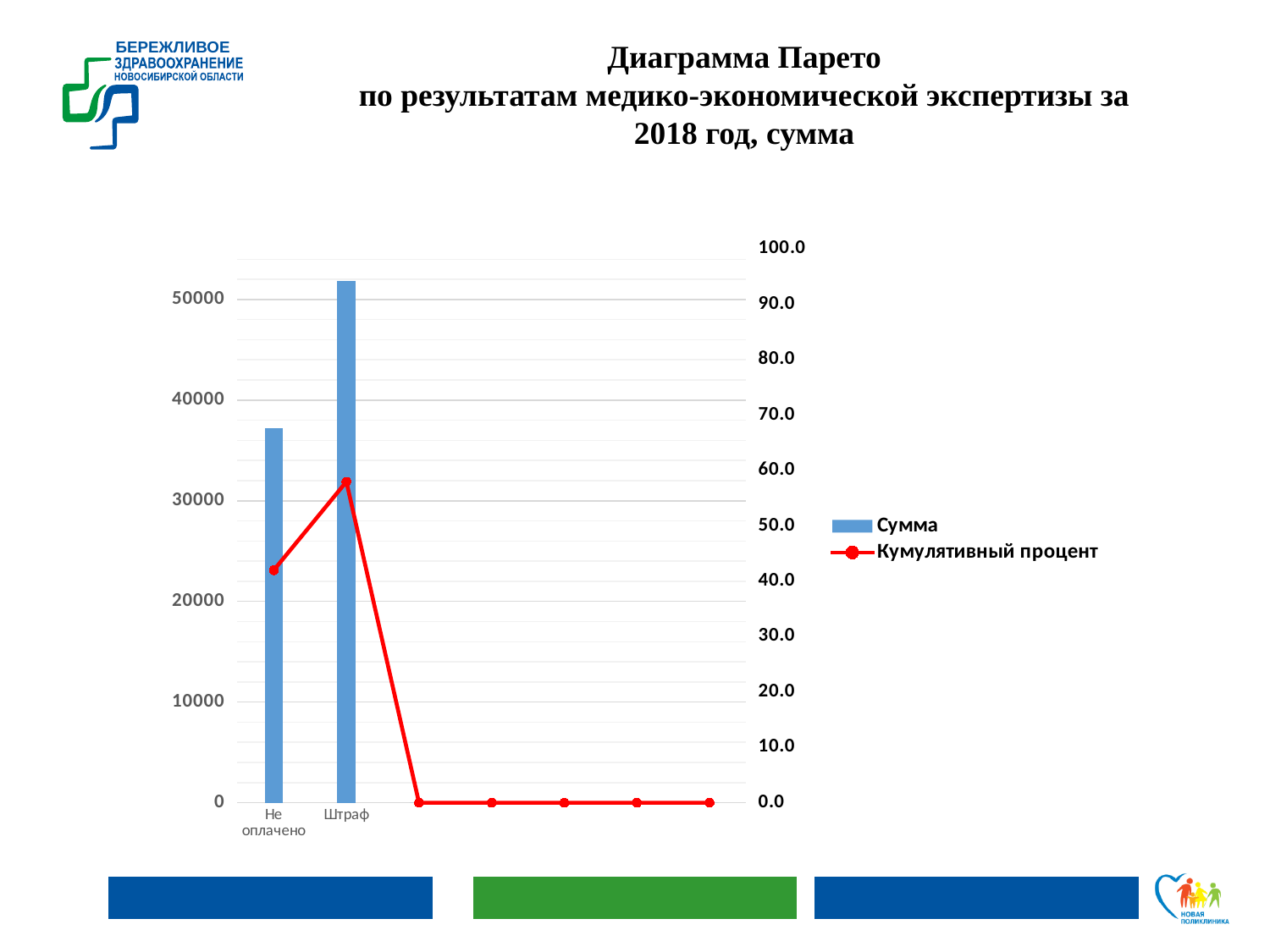
Is the Кумулятивный процент value for Штраф greater or less than 60.0? less How many series does the legend list? 2 Is the Сумма value for Штраф greater or less than 50000? greater Which category has the highest Сумма bar? Штраф Is the Сумма value for Не оплачено greater or less than 30000? greater Which category has the lowest Сумма bar? Не оплачено Which has the larger Сумма value, Не оплачено or Штраф? Штраф What kind of chart is shown on the slide? A combined bar and line chart How many labelled categories have a Сумма bar? 2 What are the two entries in the chart legend? Сумма and Кумулятивный процент